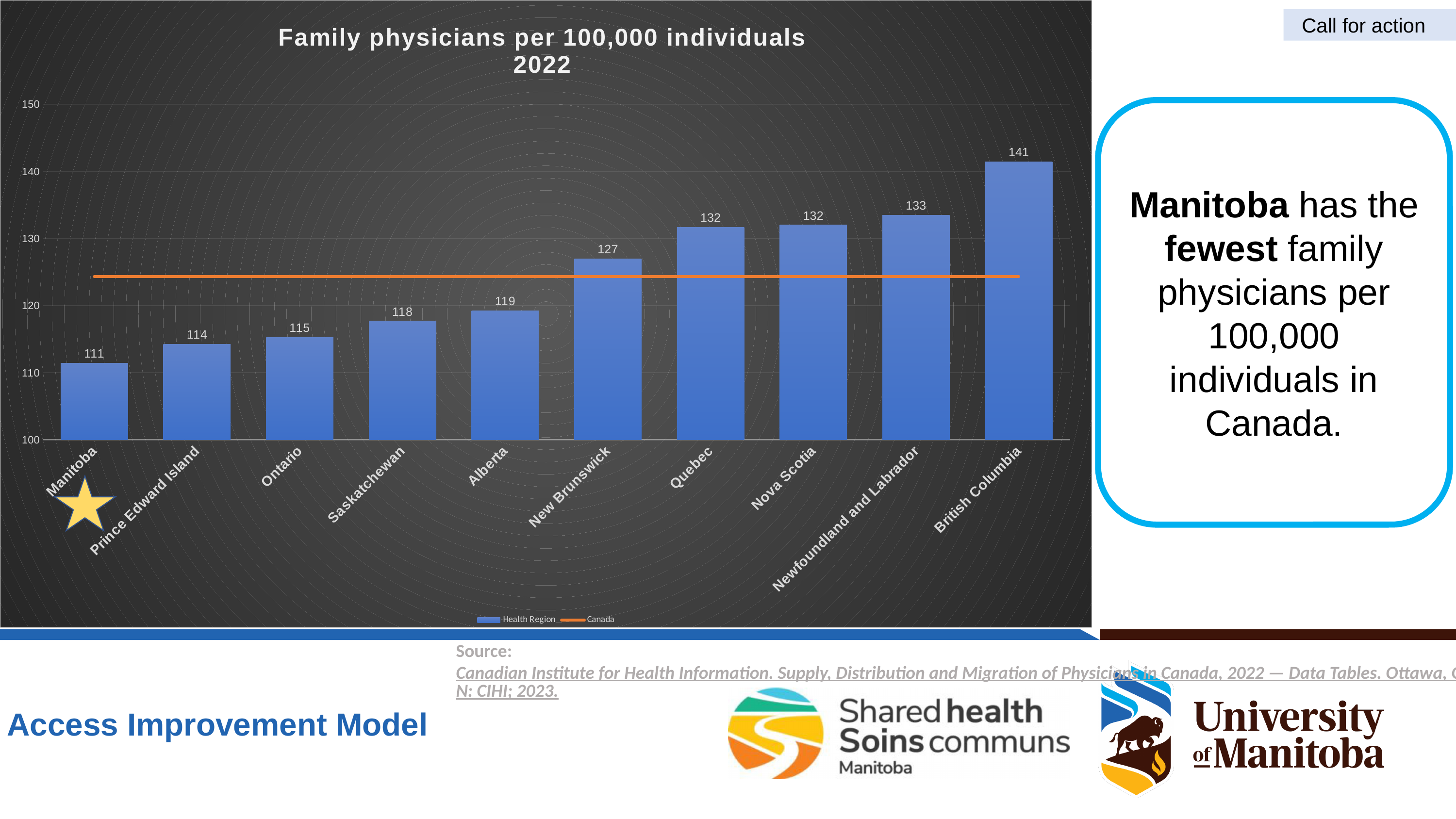
Which is larger, the value for Alberta or the value for Newfoundland and Labrador? Newfoundland and Labrador How many provinces are shown on the x axis? 10 Which province has the lowest number of family physicians per 100,000 individuals? Manitoba What is the difference between the values for British Columbia and Manitoba? 30 Is the Canada line greater or less than 120? greater What is the value for Manitoba? 111 How many series does the legend list? 2 Which province has the highest number of family physicians per 100,000 individuals? British Columbia What kind of chart is shown? Bar chart What is the value for British Columbia? 141 What is the value for New Brunswick? 127 Do the bar values rise or fall from left to right along the x axis? Rise